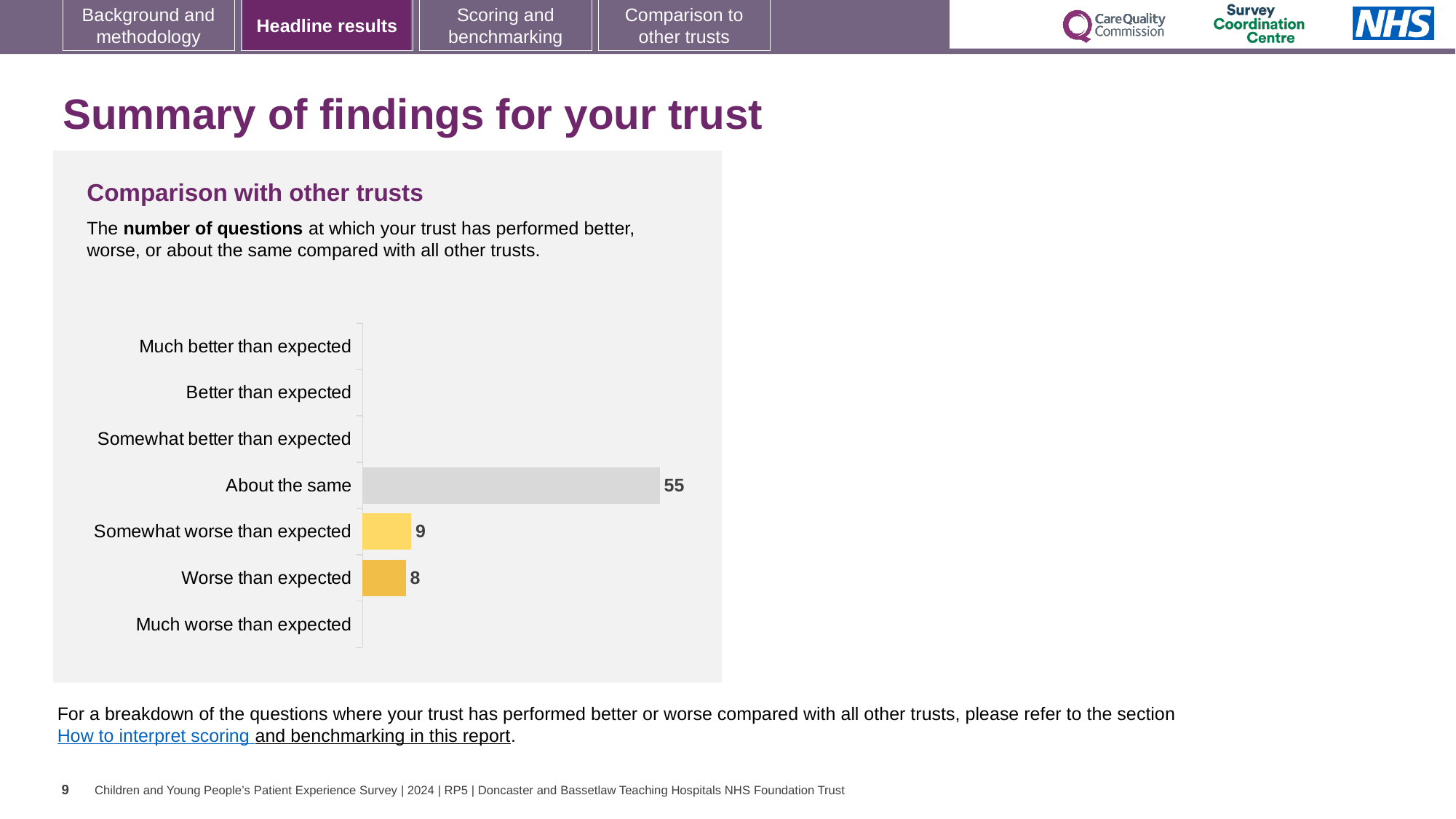
What is the value for 'Somewhat worse than expected'? 9 How many categories are listed on the chart's axis? 7 What is the value for 'Worse than expected'? 8 What colour is the bar for 'About the same'? Grey What is the title of the chart section? Comparison with other trusts How many categories have a visible bar with a data label? 3 What is the difference between 'Somewhat worse than expected' and 'Worse than expected'? 1 What is the difference between 'About the same' and 'Somewhat worse than expected'? 46 Which is larger, 'About the same' or 'Worse than expected'? About the same What kind of chart is shown? Bar chart What is the value for 'About the same'? 55 Which category has the highest value? About the same